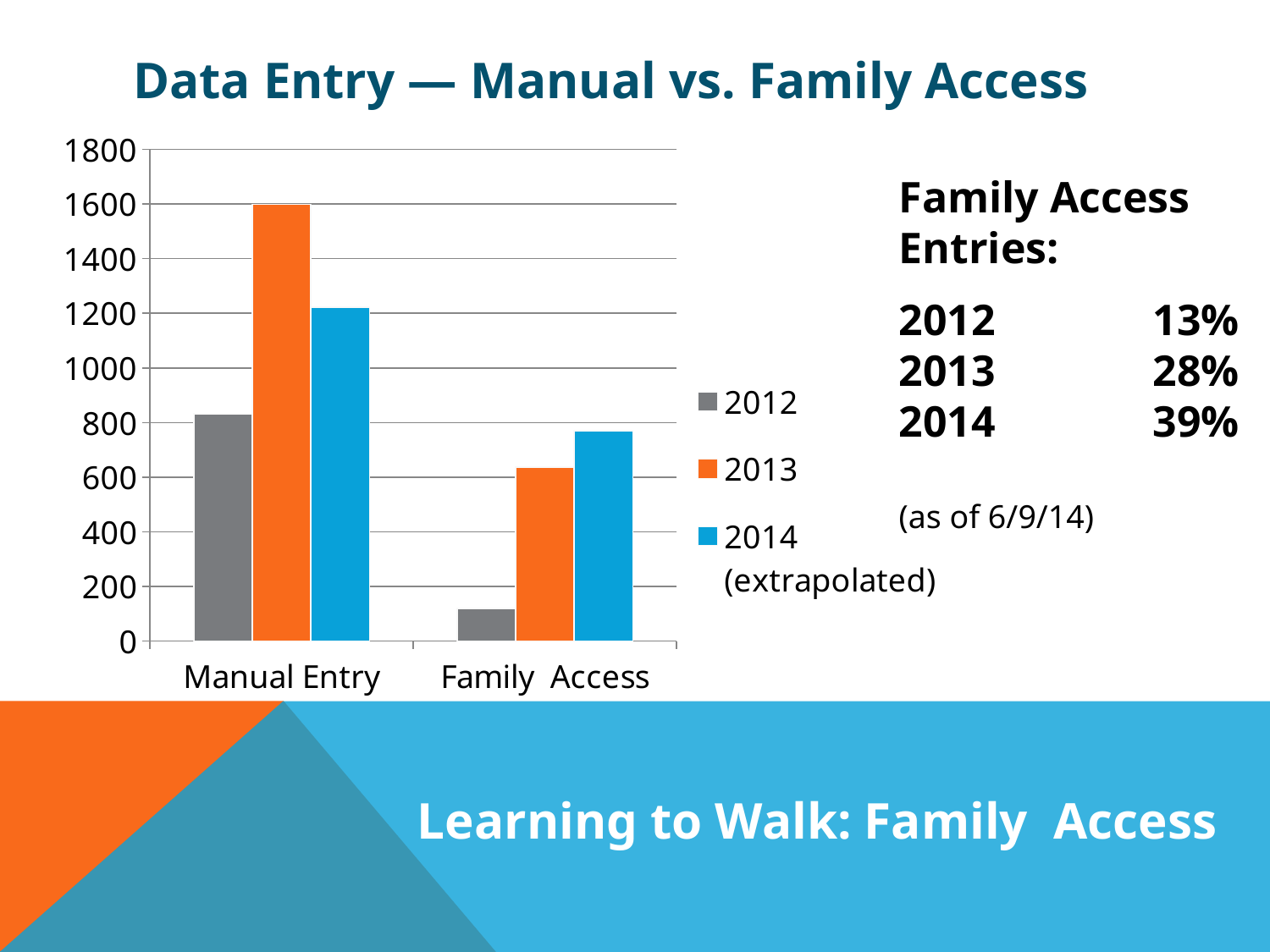
Which is larger: Manual Entry in 2012 or Family Access in 2014? Manual Entry in 2012 What is the title of the chart on the slide? Data Entry — Manual vs. Family Access Is the value for Family Access in 2012 greater or less than 200? less Which colour represents the 2013 series in the chart? orange Which year has the highest value for Manual Entry? 2013 What kind of chart is shown on the slide? bar chart Which year has the lowest value for Family Access? 2012 Is the value for Manual Entry in 2014 greater or less than 1000? greater Is the value for Manual Entry in 2012 greater or less than 1000? less How many series does the chart legend list? 3 How many categories are shown on the x axis of the chart? 2